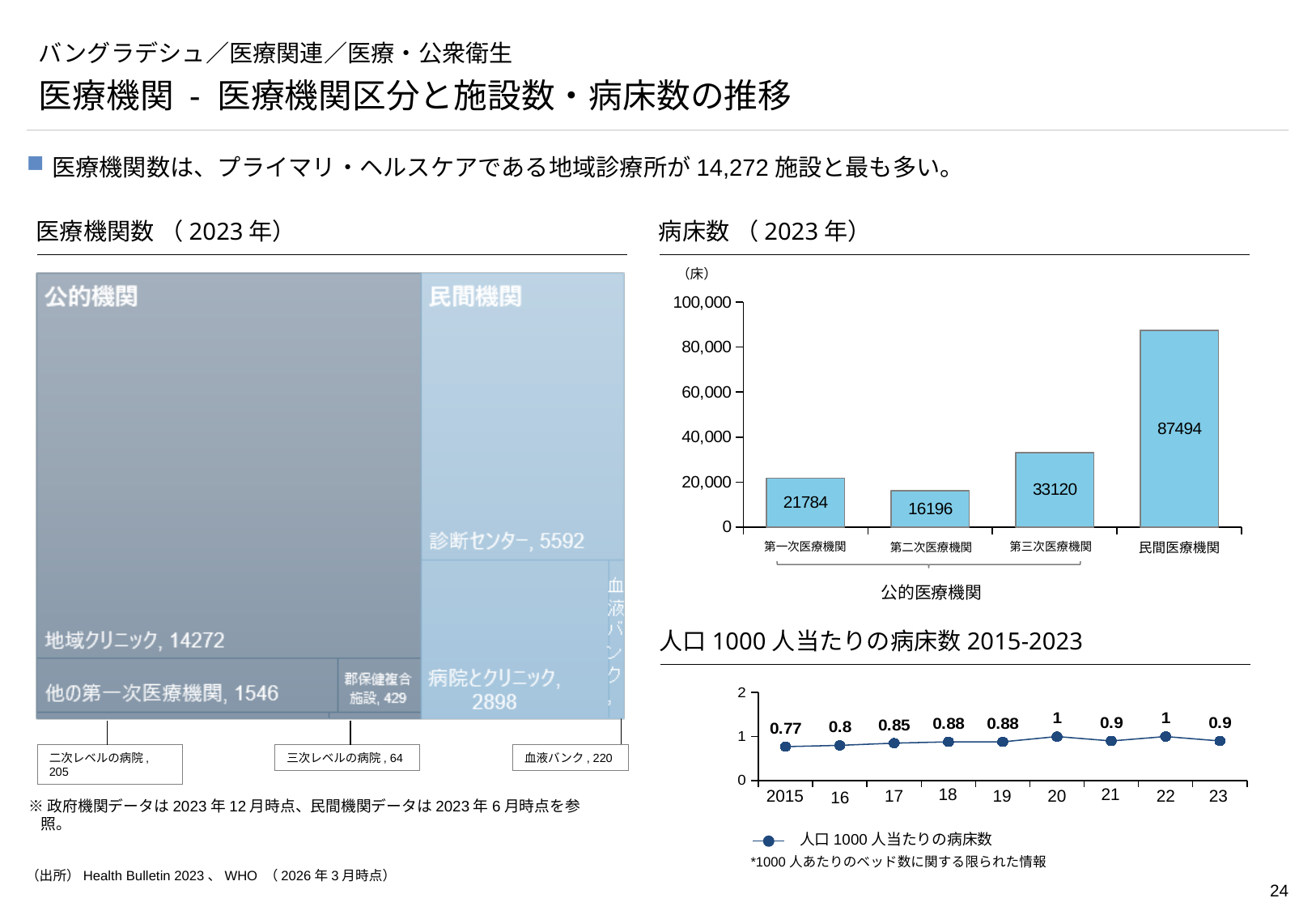
In the 人口1000人当たりの病床数 2015-2023 chart, how many data points are plotted? 9 In the 病床数（2023年） chart, how many categories are shown on the x axis? 4 In the 人口1000人当たりの病床数 2015-2023 chart, is the value for 2020 larger or smaller than the value for 2021? Larger In the 病床数（2023年） chart, what is the value for 第二次医療機関? 16196 What kind of chart is the 病床数（2023年） chart? Bar chart In the 病床数（2023年） chart, what is the value for 民間医療機関? 87494 In the 人口1000人当たりの病床数 2015-2023 chart, what is the value for 2015? 0.77 In the 人口1000人当たりの病床数 2015-2023 chart, what is the value for 2017? 0.85 In the 病床数（2023年） chart, which category has the lowest number of beds? 第二次医療機関 In the 医療機関数（2023年） treemap, what is the value for 三次レベルの病院? 64 In the 医療機関数（2023年） treemap, what is the value for 診断センター? 5592 In the 病床数（2023年） chart, what is the difference between 第三次医療機関 and 第一次医療機関? 11336